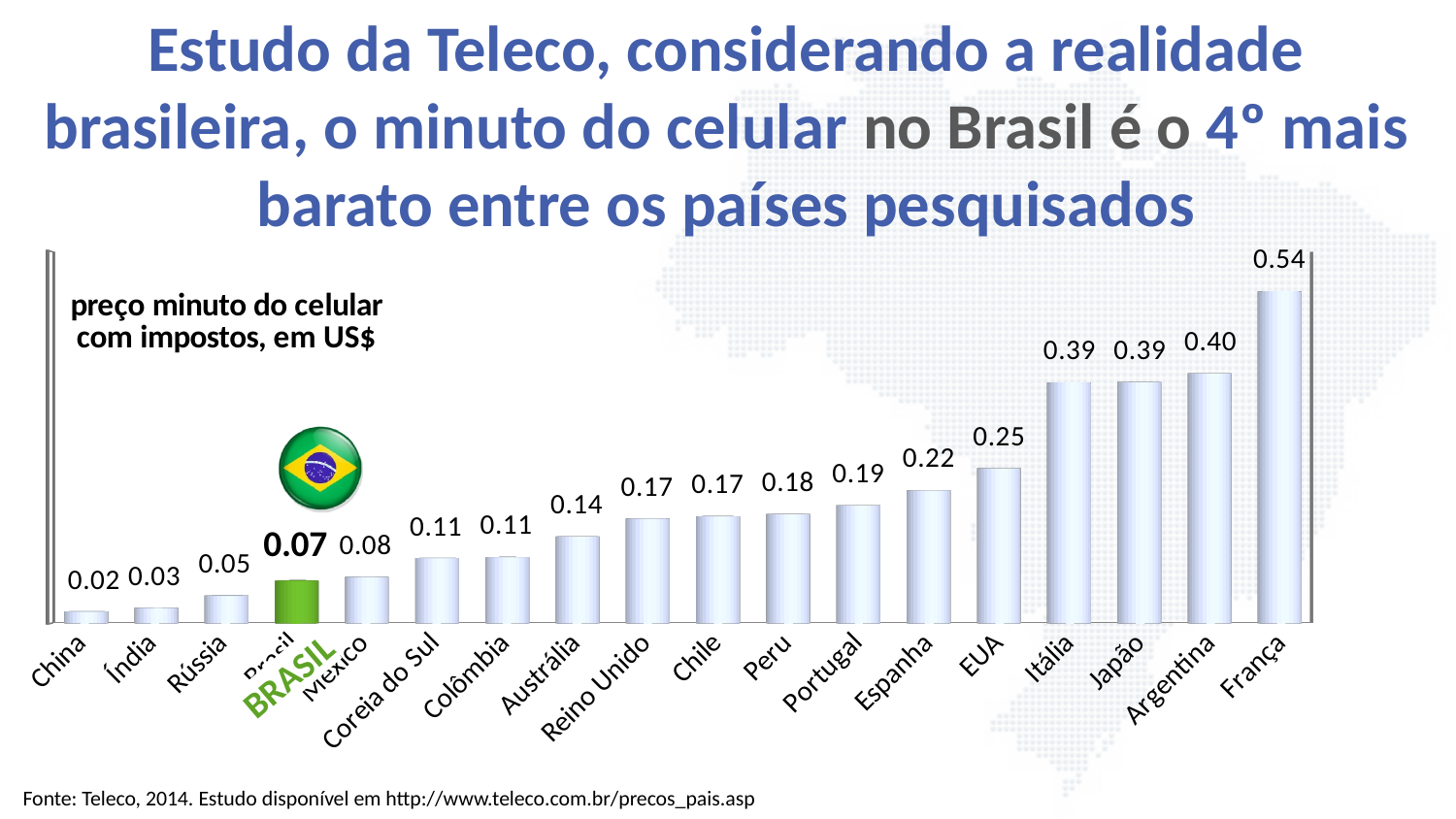
What is the value for Brasil? 0.07 What is the value for EUA? 0.25 What kind of chart is shown on the slide? bar chart What is the value for França? 0.54 Do the values rise or fall from left to right along the x axis? rise What is the difference between the values for Argentina and Espanha? 0.18 Which country has the lowest value? China Which country has the highest value? França How many countries are shown in the chart? 18 What is the difference between the values for França and Brasil? 0.47 What does the chart measure, according to the label inside the plot area? preço minuto do celular com impostos, em US$ Which is larger, the value for Portugal or the value for Austrália? Portugal